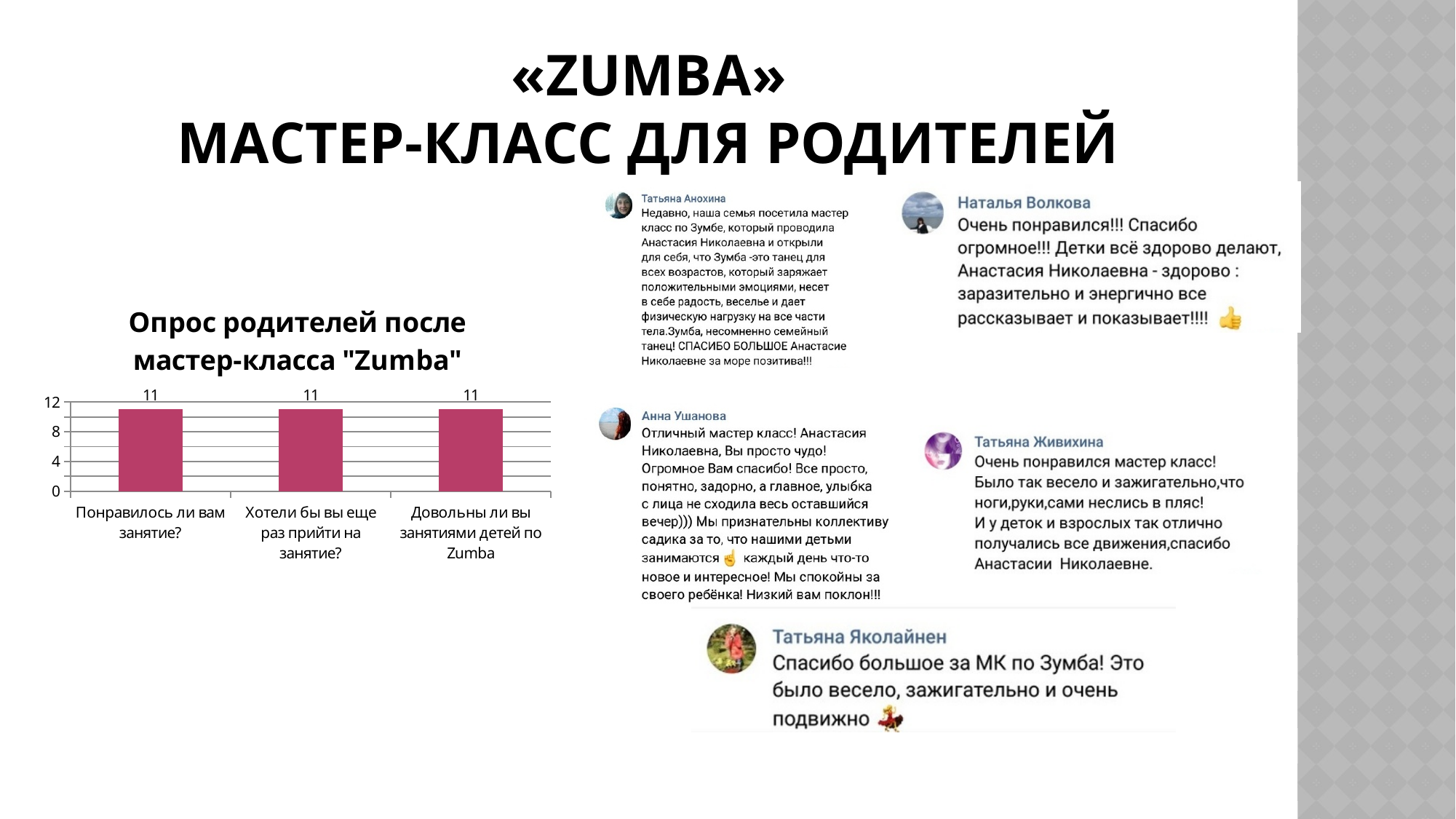
What is the value for "Довольны ли вы занятиями детей по Zumba"? 11 What is the difference between the values for "Понравилось ли вам занятие?" and "Хотели бы вы еще раз прийти на занятие?"? 0 What kind of chart is shown on the slide? bar chart How many categories are shown on the chart? 3 What is the value for "Хотели бы вы еще раз прийти на занятие?"? 11 Is the value for "Понравилось ли вам занятие?" greater or less than 8? greater What is the title of the chart? Опрос родителей после мастер-класса "Zumba" What is the value for "Понравилось ли вам занятие?"? 11 Is the value for "Довольны ли вы занятиями детей по Zumba" greater or less than 12? less What is the highest value shown on the vertical axis of the chart? 12 Do the values rise, fall or stay the same across the categories from left to right? stay the same